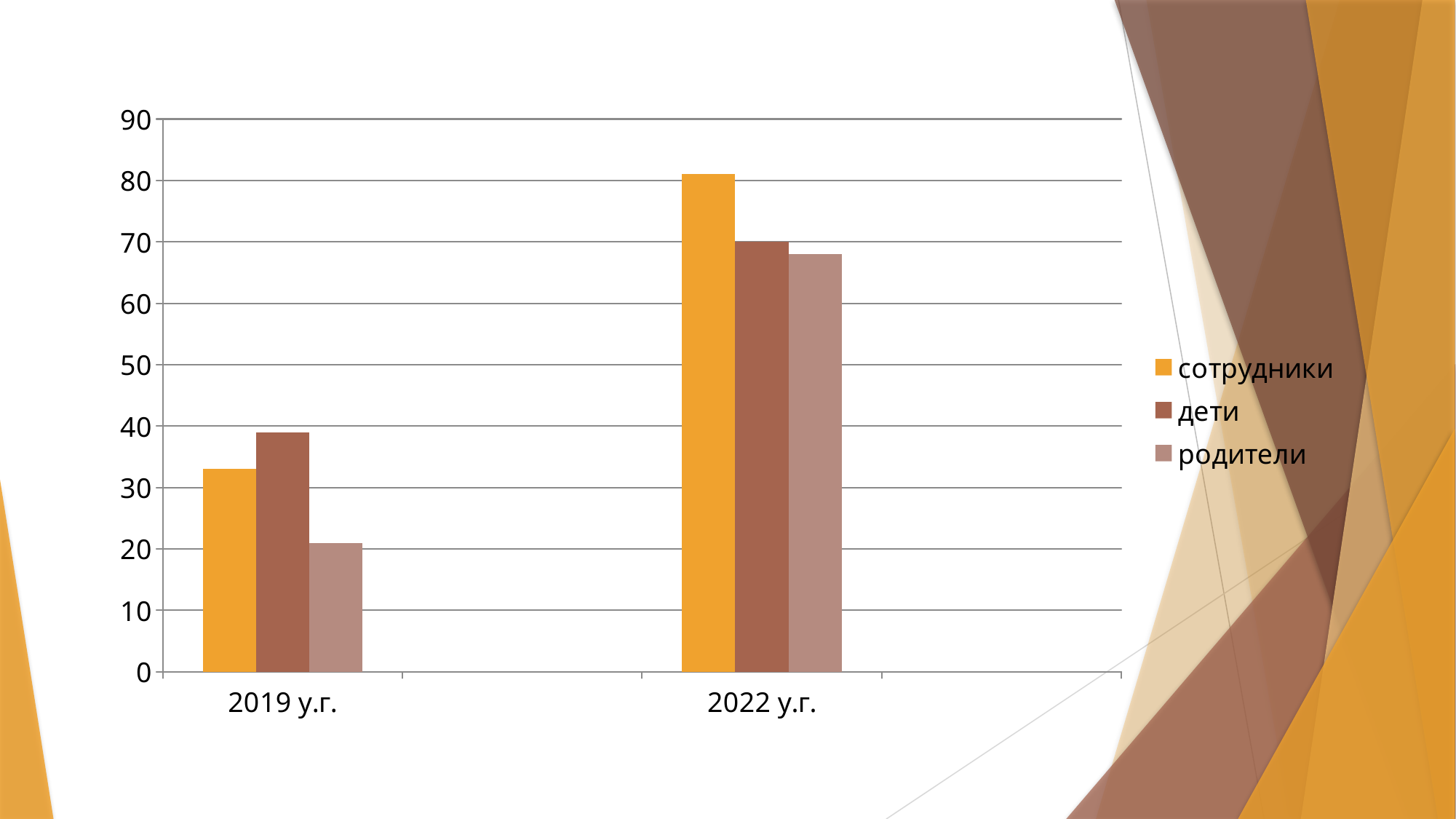
Is the value for сотрудники in 2019 у.г. greater or less than 30? greater Is the value for родители in 2022 у.г. greater or less than 60? greater Is the value for сотрудники in 2022 у.г. greater or less than 70? greater Which series has the lowest value for 2019 у.г.? родители Which series has the highest value for 2019 у.г.? дети Do the values for сотрудники rise or fall from 2019 у.г. to 2022 у.г.? rise How many series does the legend list? 3 How many categories are shown on the x axis? 2 Which is larger for 2022 у.г.: сотрудники or дети? сотрудники What kind of chart is shown on the slide? bar chart Which series has the highest value for 2022 у.г.? сотрудники